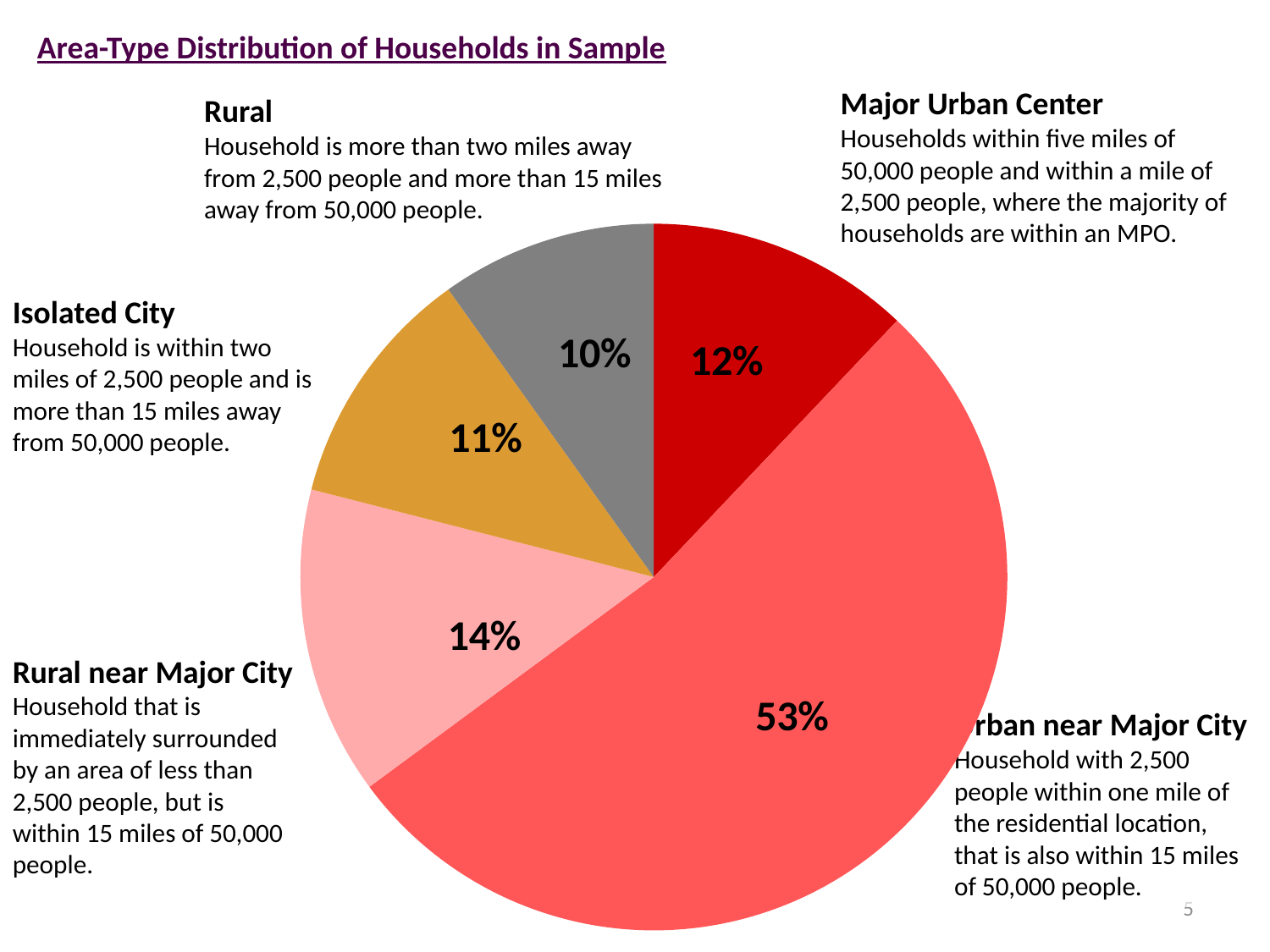
What is the difference in percentage points between the 53% slice and the 14% slice? 39 percentage points What is the title of the slide containing the pie chart? Area-Type Distribution of Households in Sample What share of households in the sample are in the Urban near Major City area type? 53% What is the difference in percentage points between the pink slice (14%) and the gray slice (10%)? 4 percentage points What percentage is shown on the gray slice of the pie chart? 10% What percentage is shown on the dark red slice of the pie chart? 12% Which is larger, the Major Urban Center slice (12%) or the Isolated City slice (11%)? Major Urban Center What colour is the slice labelled 11% on the pie chart? Gold What is the smallest percentage shown on the pie chart? 10% What kind of chart is shown on the slide? Pie chart How many slices does the pie chart have? 5 What is the largest percentage shown on the pie chart? 53%